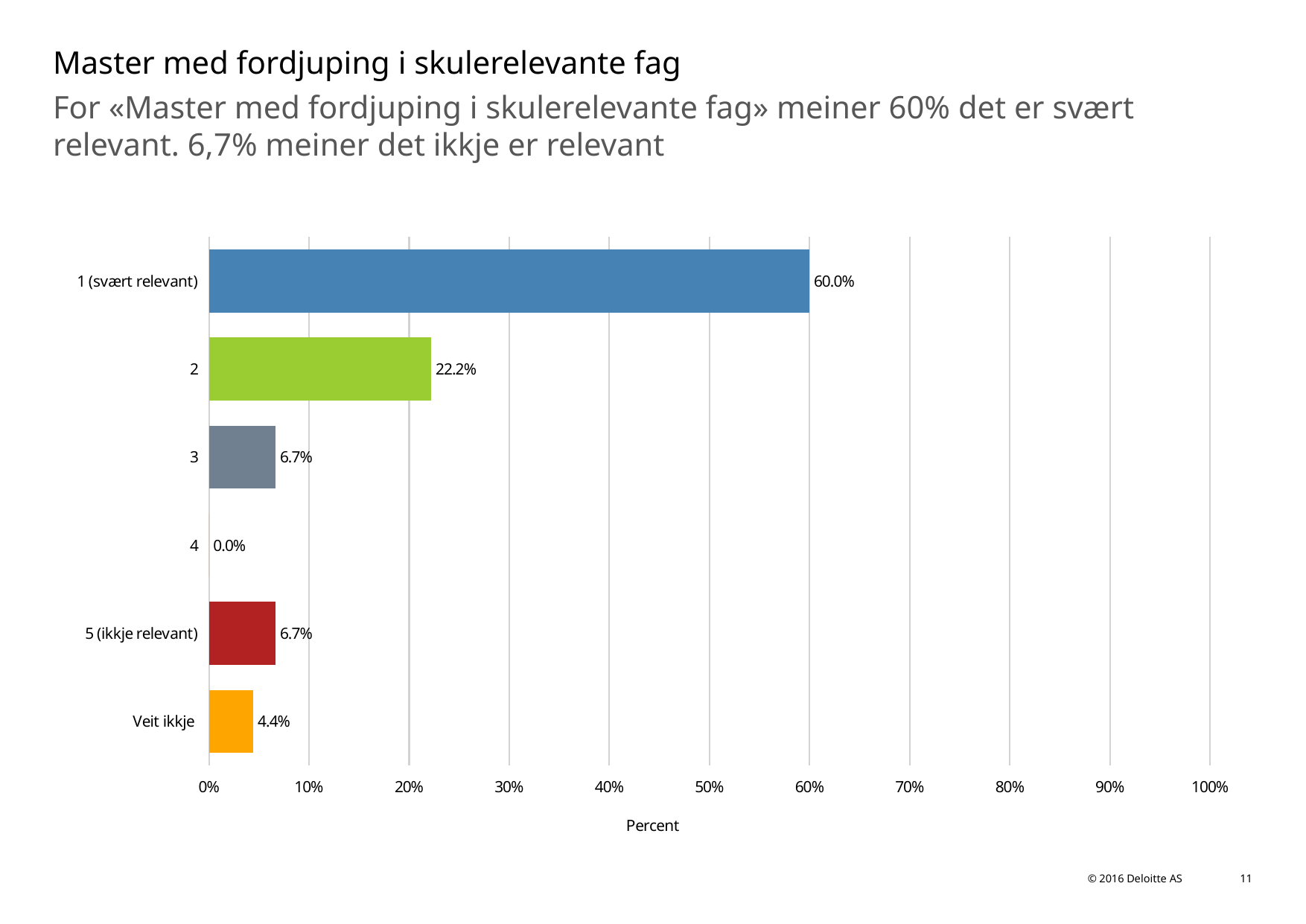
What is the value for category "2"? 22.2% What is the label of the horizontal axis? Percent Which category has the lowest value? 4 Which category has the highest value? 1 (svært relevant) What kind of chart is shown on the slide? Bar chart What is the value for category "4"? 0.0% Is the value for "2" greater or less than 20%? greater What is the value for "1 (svært relevant)"? 60.0% What is the difference between the values for "1 (svært relevant)" and "2"? 37.8% What is the value for "Veit ikkje"? 4.4% How many categories are shown on the chart? 6 Which is larger, the value for "3" or the value for "Veit ikkje"? 3